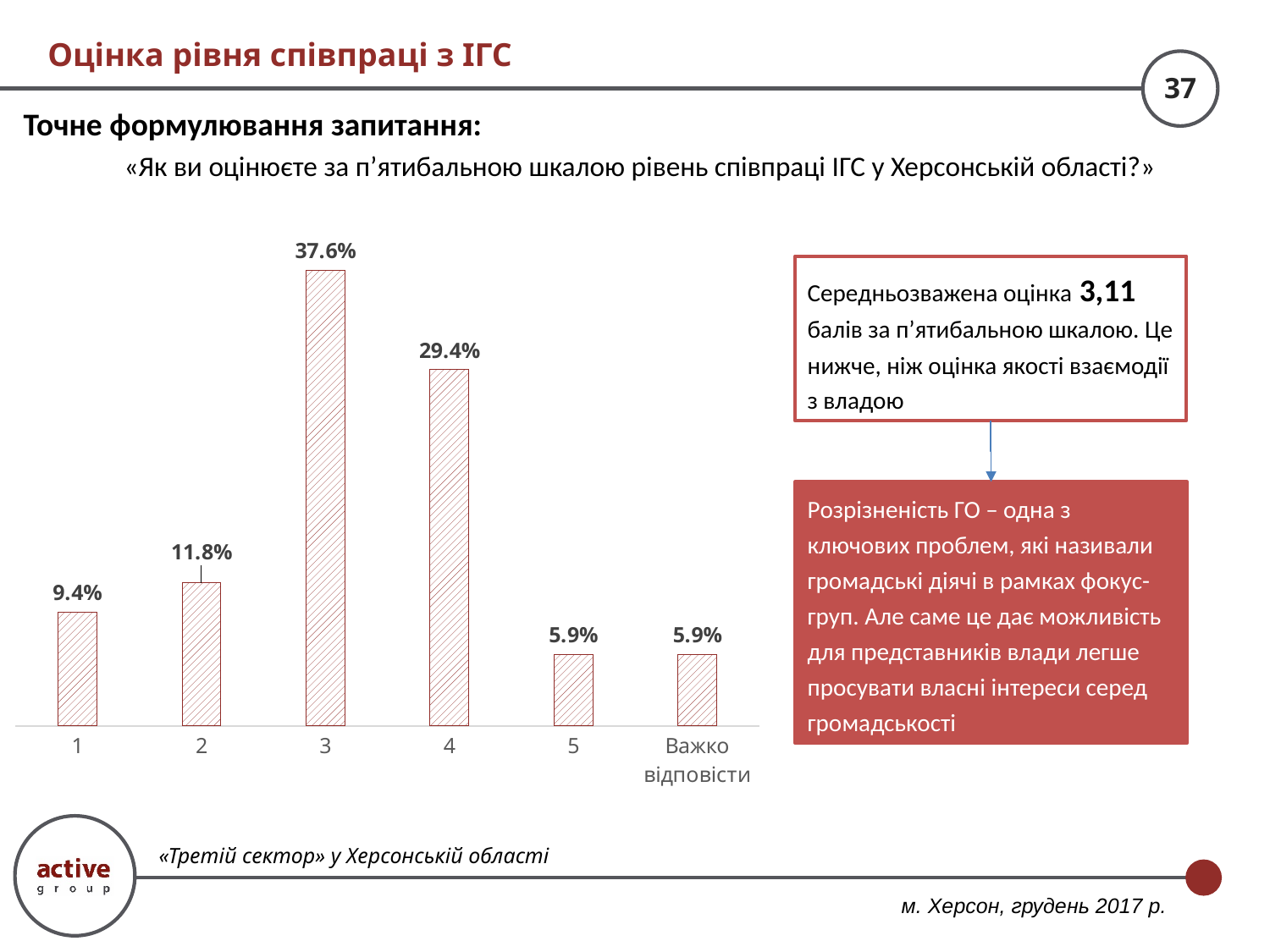
What is the difference between the values for rating 3 and rating 4? 8.2% Do the values rise or fall from rating 3 to rating 5? fall What is the value shown for rating 1? 9.4% What kind of chart is shown on the slide? bar chart What is the value shown for the category "Важко відповісти"? 5.9% Which is larger, the value for rating 2 or the value for rating 5? rating 2 What is the value shown for rating 4? 29.4% What is the difference between the values for rating 2 and rating 1? 2.4% How many categories are shown on the x axis of the chart? 6 Which rating category has the highest value? 3 What percentage of respondents gave a rating of 3? 37.6% What is the combined value of rating 4 and rating 5? 35.3%